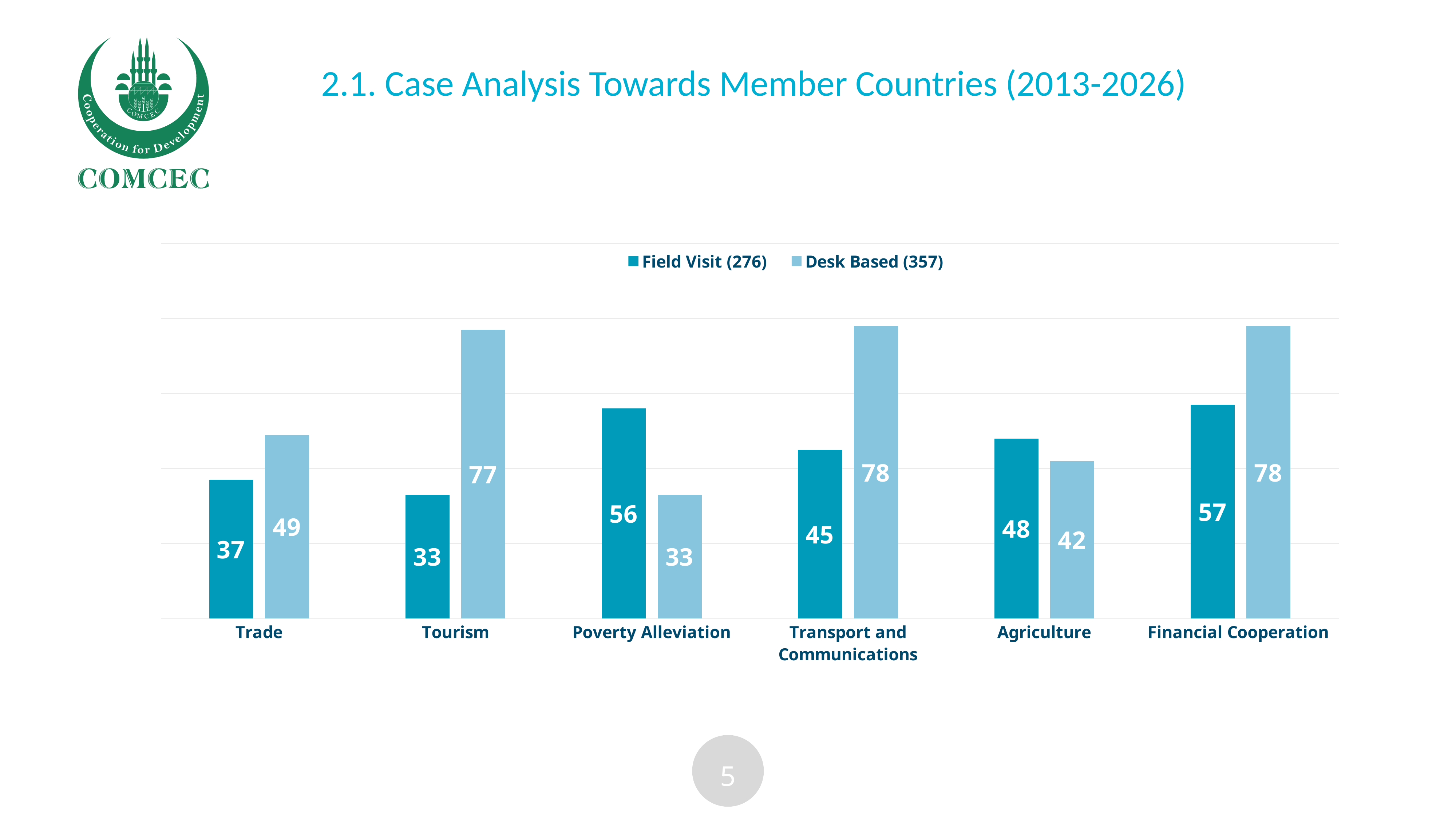
How many series does the legend list? 2 Which category has the lowest Field Visit value? Tourism What is the Field Visit value for Trade? 37 How many categories are shown on the x axis? 6 What is the Field Visit value for Agriculture? 48 What is the difference between the Desk Based and Field Visit values for Tourism? 44 Which category has the highest Field Visit value? Financial Cooperation What kind of chart is shown on the slide? Bar chart What is the Desk Based value for Tourism? 77 Which category has the lowest Desk Based value? Poverty Alleviation What is the Desk Based value for Transport and Communications? 78 For Poverty Alleviation, which is larger: the Field Visit value or the Desk Based value? Field Visit